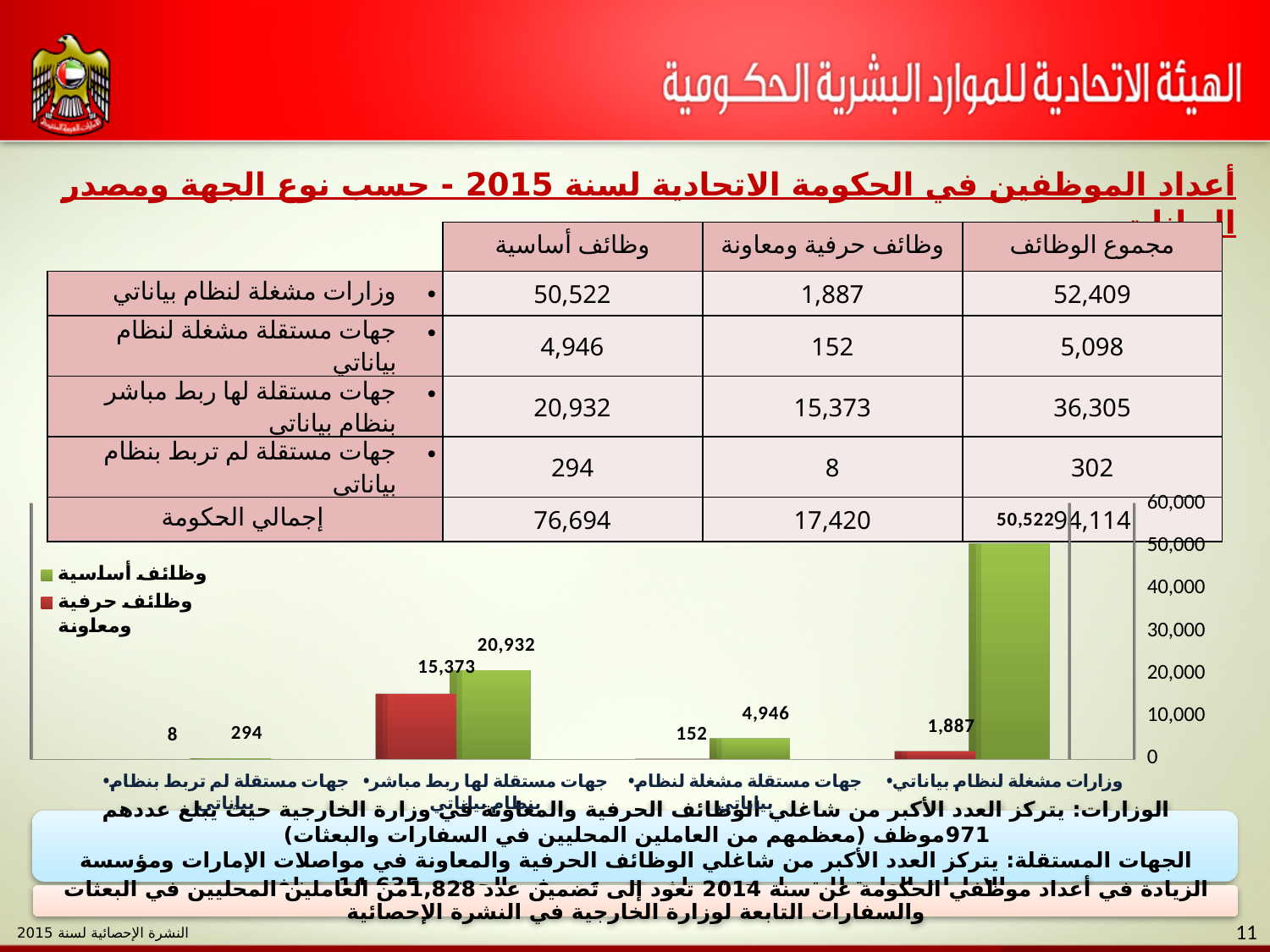
In the chart, which is larger for وزارات مشغلة لنظام بياناتي: وظائف أساسية or وظائف حرفية ومعاونة? وظائف أساسية How many series does the chart legend list? 2 Which category has the lowest value for وظائف حرفية ومعاونة in the chart? جهات مستقلة لم تربط بنظام بياناتي In the chart, what is the difference between وظائف أساسية and وظائف حرفية ومعاونة for جهات مستقلة لها ربط مباشر بنظام بياناتي? 5,559 Is the value of وظائف أساسية for وزارات مشغلة لنظام بياناتي greater or less than 40,000? greater How many categories are shown on the x axis of the chart? 4 Which category has the highest value for وظائف أساسية in the chart? وزارات مشغلة لنظام بياناتي In the chart, what is the value of وظائف حرفية ومعاونة for جهات مستقلة لم تربط بنظام بياناتي? 8 In the chart, what is the value of وظائف أساسية for جهات مستقلة مشغلة لنظام بياناتي? 4,946 In the chart, what is the value of وظائف أساسية for وزارات مشغلة لنظام بياناتي? 50,522 In the chart, what is the value of وظائف حرفية ومعاونة for جهات مستقلة لها ربط مباشر بنظام بياناتي? 15,373 What kind of chart is shown on the slide? bar chart